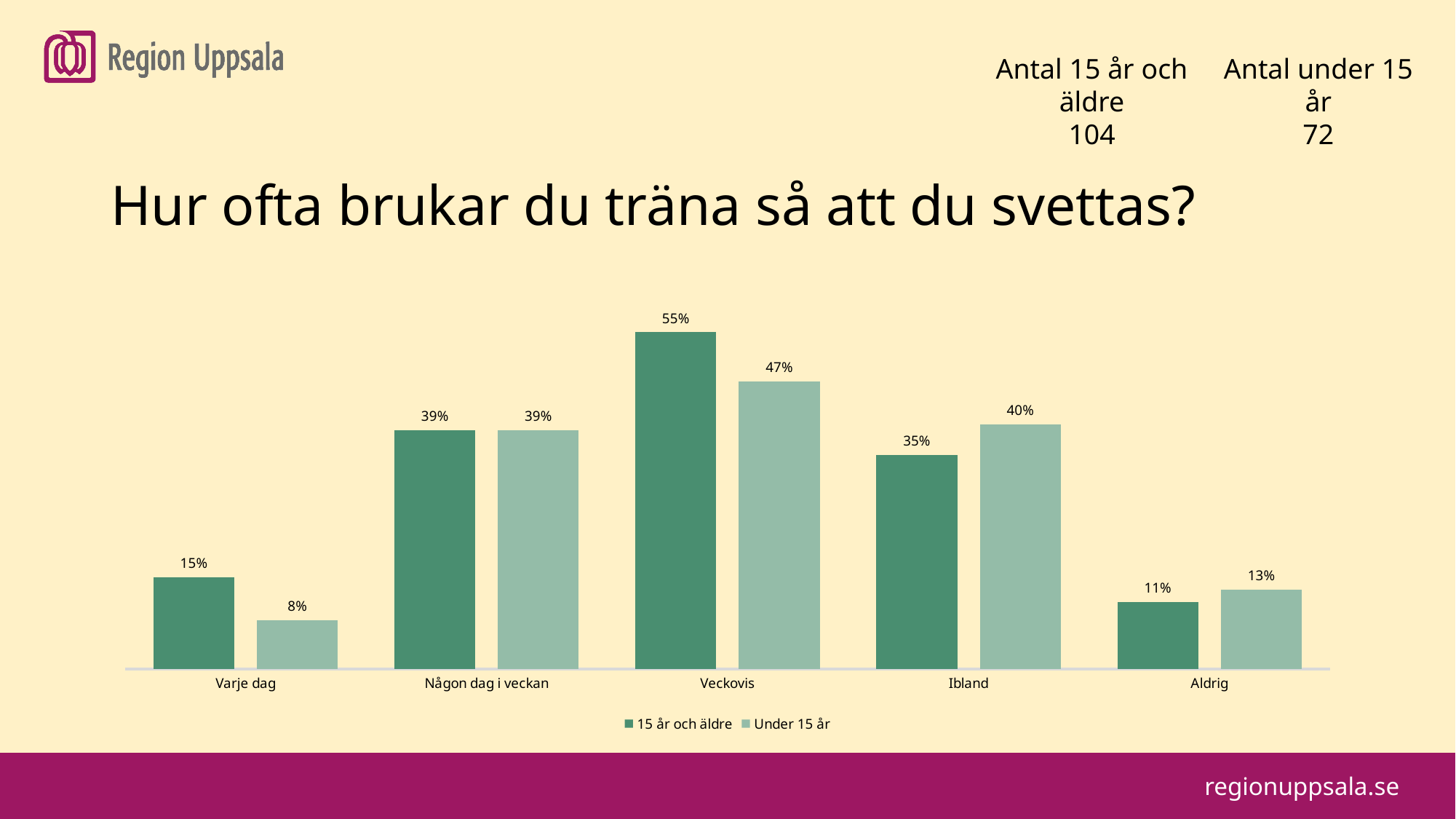
Which category has the highest value for the "15 år och äldre" series? Veckovis What is the value for "15 år och äldre" in the "Veckovis" category? 55% How many categories are shown on the x axis? 5 What is the difference between the "15 år och äldre" and "Under 15 år" values in the "Varje dag" category? 7% What is the difference between the "15 år och äldre" and "Under 15 år" values in the "Veckovis" category? 8% Which category has the lowest value for the "Under 15 år" series? Varje dag What is the value for "Under 15 år" in the "Varje dag" category? 8% How many series does the legend list? 2 What kind of chart is shown on the slide? Bar chart What is the title of the chart on the slide? Hur ofta brukar du träna så att du svettas? In the "Ibland" category, which series has the larger value? Under 15 år What is the value for "Under 15 år" in the "Ibland" category? 40%